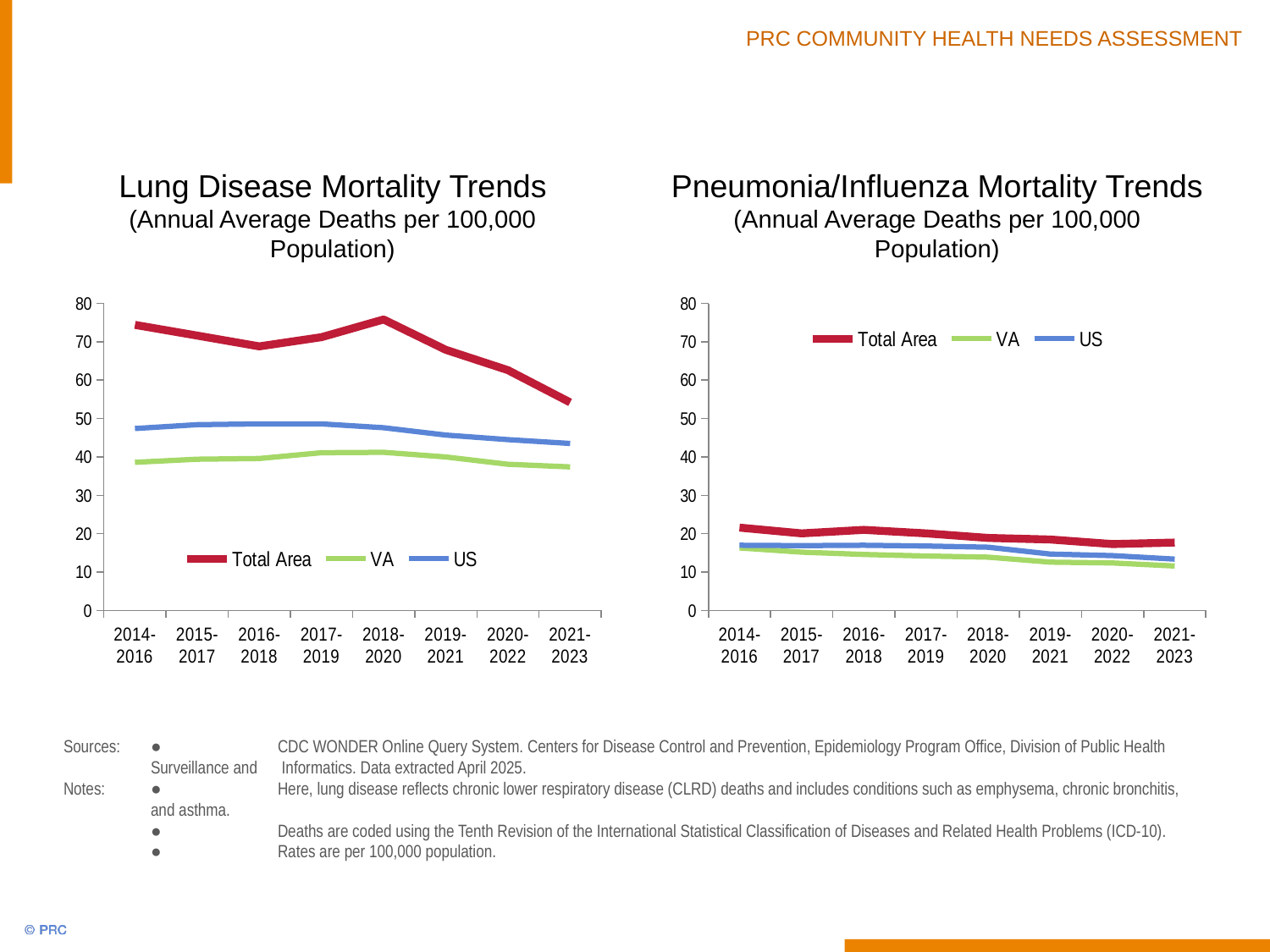
In the Lung Disease Mortality Trends chart, is the Total Area value for 2021-2023 greater or less than 60? less In the Lung Disease Mortality Trends chart, in which period is the Total Area value highest? 2018-2020 How many time periods are shown on the x axis of the Lung Disease Mortality Trends chart? 8 How many series does the legend of the Pneumonia/Influenza Mortality Trends chart list? 3 In the Pneumonia/Influenza Mortality Trends chart, does the VA line generally rise or fall from 2014-2016 to 2021-2023? fall In the Pneumonia/Influenza Mortality Trends chart, is the VA value for 2021-2023 greater or less than 15? less What kind of chart is the Lung Disease Mortality Trends chart? line chart In the Lung Disease Mortality Trends chart, is the Total Area value for 2018-2020 greater or less than 70? greater In the Lung Disease Mortality Trends chart, in which period is the Total Area value lowest? 2021-2023 In the Lung Disease Mortality Trends chart, which is larger in 2014-2016, the US value or the VA value? US In the Pneumonia/Influenza Mortality Trends chart, which series is drawn in red? Total Area